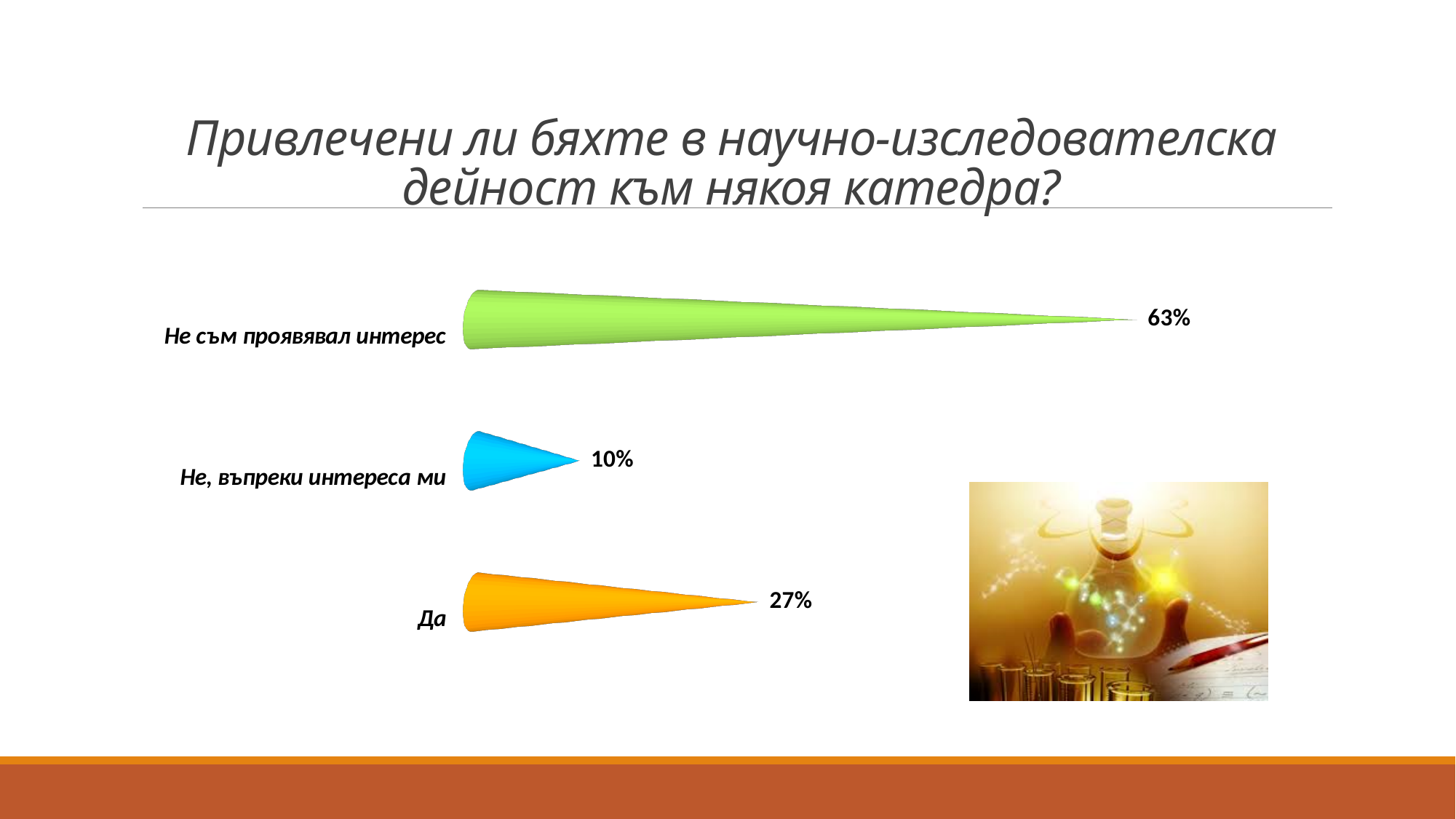
What colour is the bar for "Да"? orange What colour is the bar for "Не съм проявявал интерес"? green What is the difference between the values for "Да" and "Не, въпреки интереса ми"? 17% What is the value for "Не съм проявявал интерес"? 63% What kind of chart is shown on the slide? bar chart What is the value for "Не, въпреки интереса ми"? 10% What is the value for "Да"? 27% Which category has the highest value? Не съм проявявал интерес Which category has the lowest value? Не, въпреки интереса ми How many categories are shown in the chart? 3 Which is larger, the value for "Да" or the value for "Не, въпреки интереса ми"? Да What is the difference between the values for "Не съм проявявал интерес" and "Да"? 36%